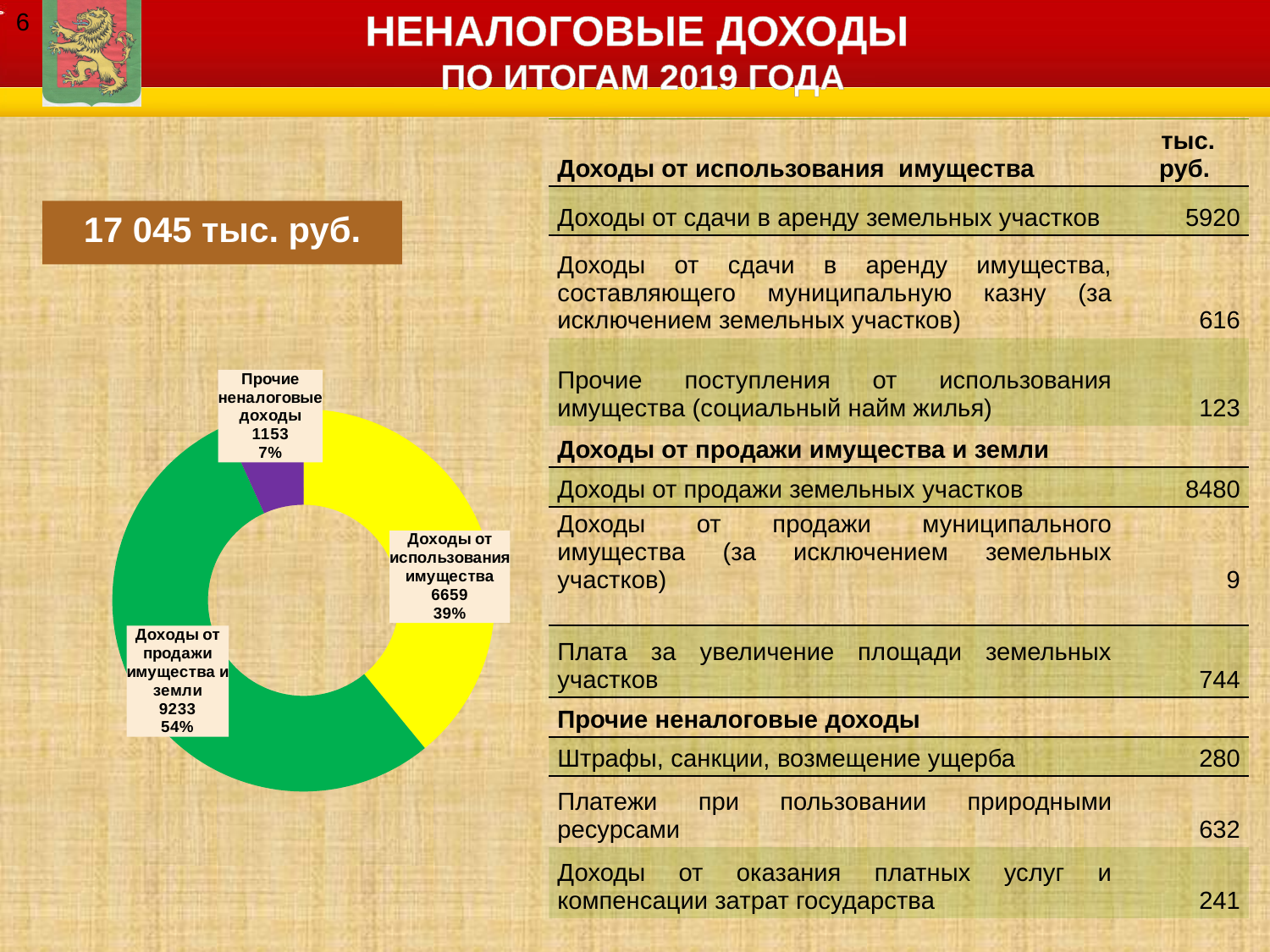
What is the value for "Доходы от продажи имущества и земли" in the doughnut chart? 9233 What share of the doughnut chart does "Прочие неналоговые доходы" represent? 7% Which category has the smallest slice in the doughnut chart? Прочие неналоговые доходы What is the value for "Прочие неналоговые доходы" in the doughnut chart? 1153 What kind of chart is shown on the slide? Doughnut chart What colour is the "Доходы от продажи имущества и земли" slice in the doughnut chart? Green What is the value for "Доходы от использования имущества" in the doughnut chart? 6659 What is the difference between "Доходы от продажи имущества и земли" and "Доходы от использования имущества" in the doughnut chart? 2574 How many slices does the doughnut chart have? 3 Which is larger in the doughnut chart: "Доходы от использования имущества" or "Прочие неналоговые доходы"? Доходы от использования имущества Which category has the largest slice in the doughnut chart? Доходы от продажи имущества и земли What share of the doughnut chart does "Доходы от использования имущества" represent? 39%